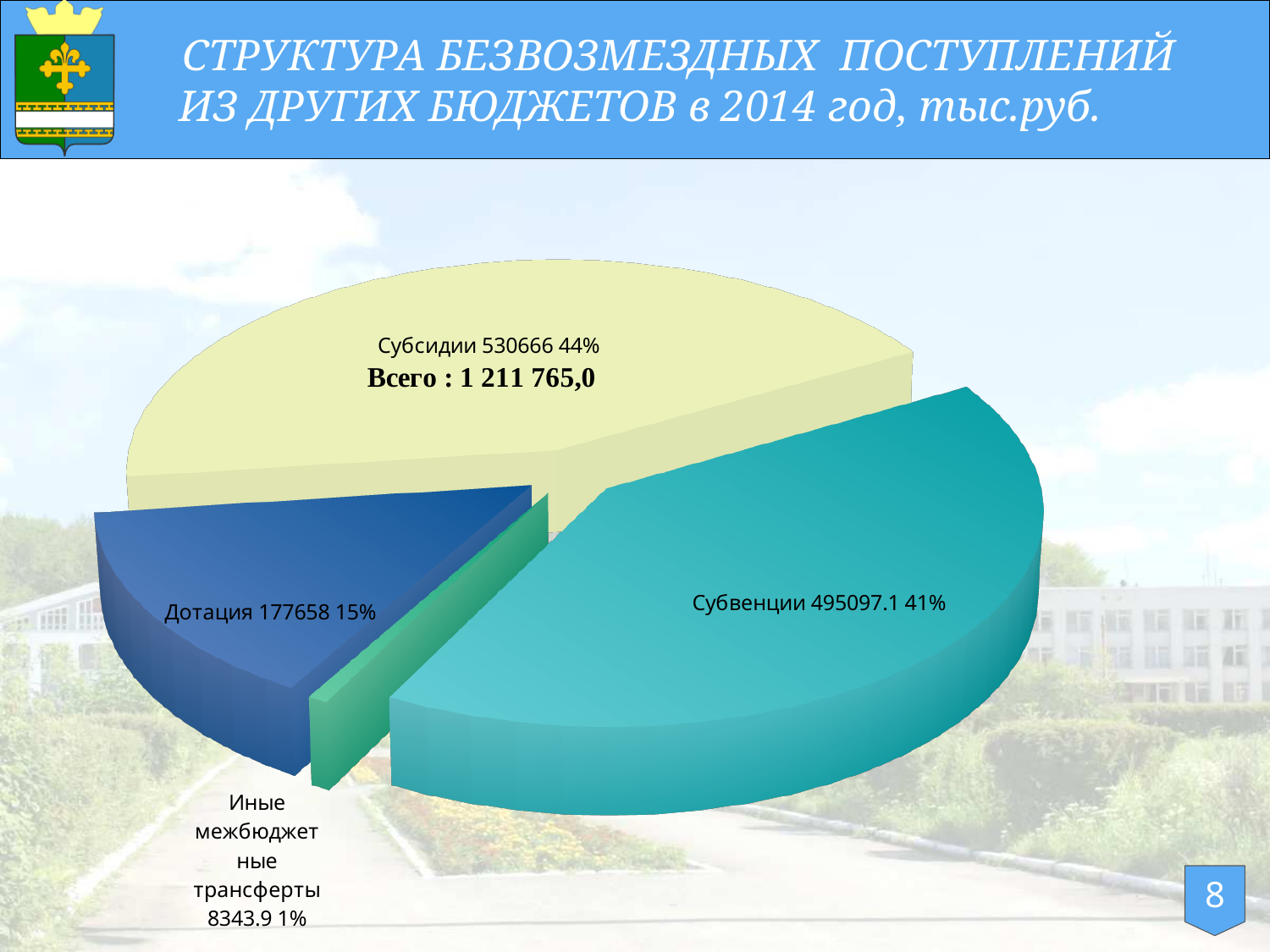
How many slices does the pie chart have? 4 What is the value for Дотация? 177658 Which category has the smallest slice? Иные межбюджетные трансферты What total (Всего) is printed on the chart? 1 211 765,0 What is the value for Субсидии? 530666 Which is larger, Дотация or Субвенции? Субвенции What is the value for Иные межбюджетные трансферты? 8343.9 What is the value for Субвенции? 495097.1 Which category has the largest slice? Субсидии What kind of chart is shown on the slide? pie chart What share of the pie does Субвенции represent? 41% What share of the pie does Дотация represent? 15%